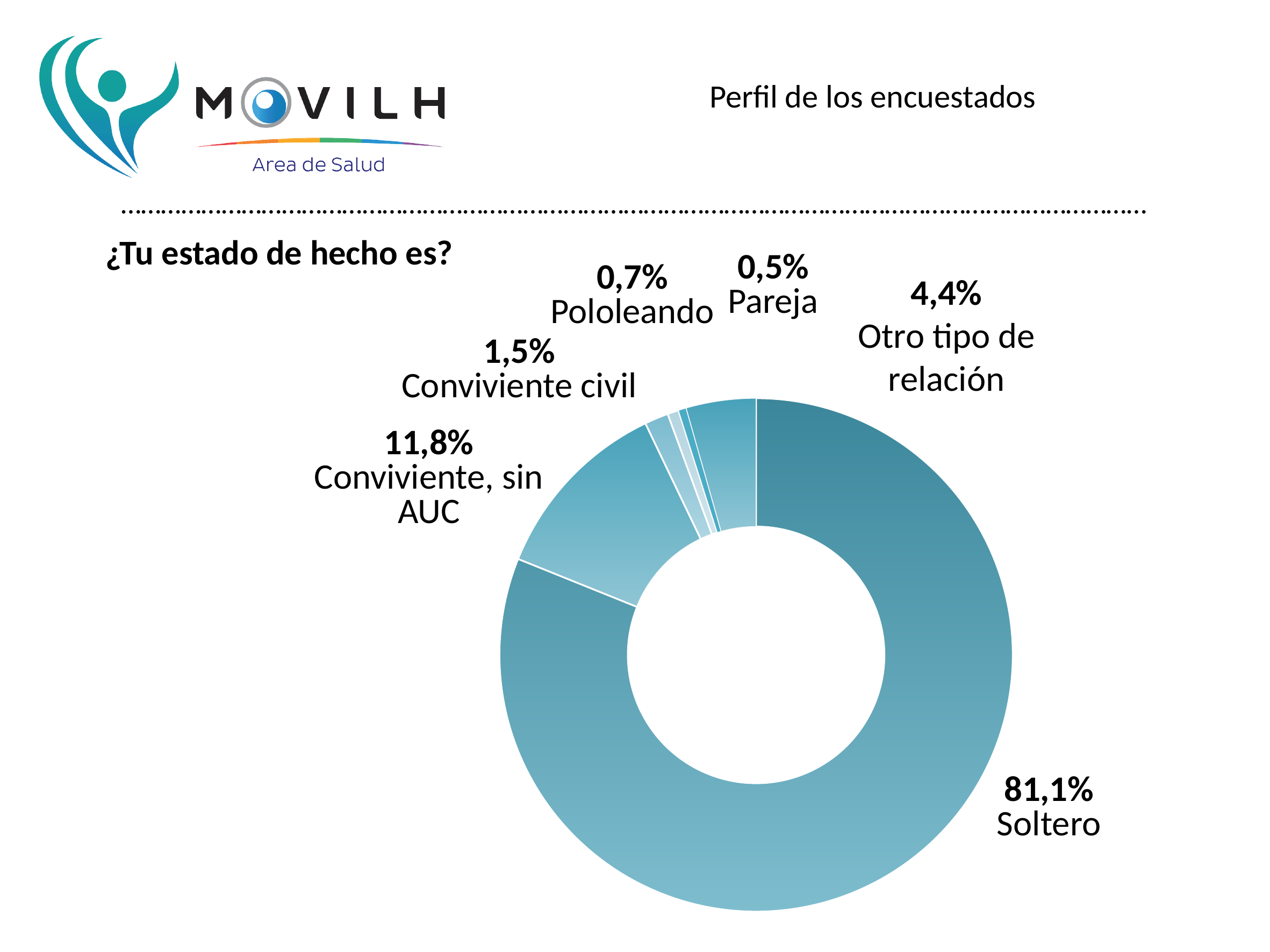
What percentage of respondents answered "Pololeando"? 0,7% Which category has the largest share of the chart? Soltero Which is larger, the share for "Otro tipo de relación" or for "Conviviente civil"? Otro tipo de relación Which category has the smallest share of the chart? Pareja How many categories are shown in the chart? 6 What percentage of respondents answered "Otro tipo de relación"? 4,4% What percentage of respondents answered "Conviviente civil"? 1,5% What percentage of respondents answered "Conviviente, sin AUC"? 11,8% What is the difference in percentage points between "Soltero" and "Conviviente, sin AUC"? 69,3 What question does the chart answer, as written above it? ¿Tu estado de hecho es? What percentage of respondents answered "Soltero"? 81,1% What kind of chart is shown on the slide? Pie chart (doughnut)